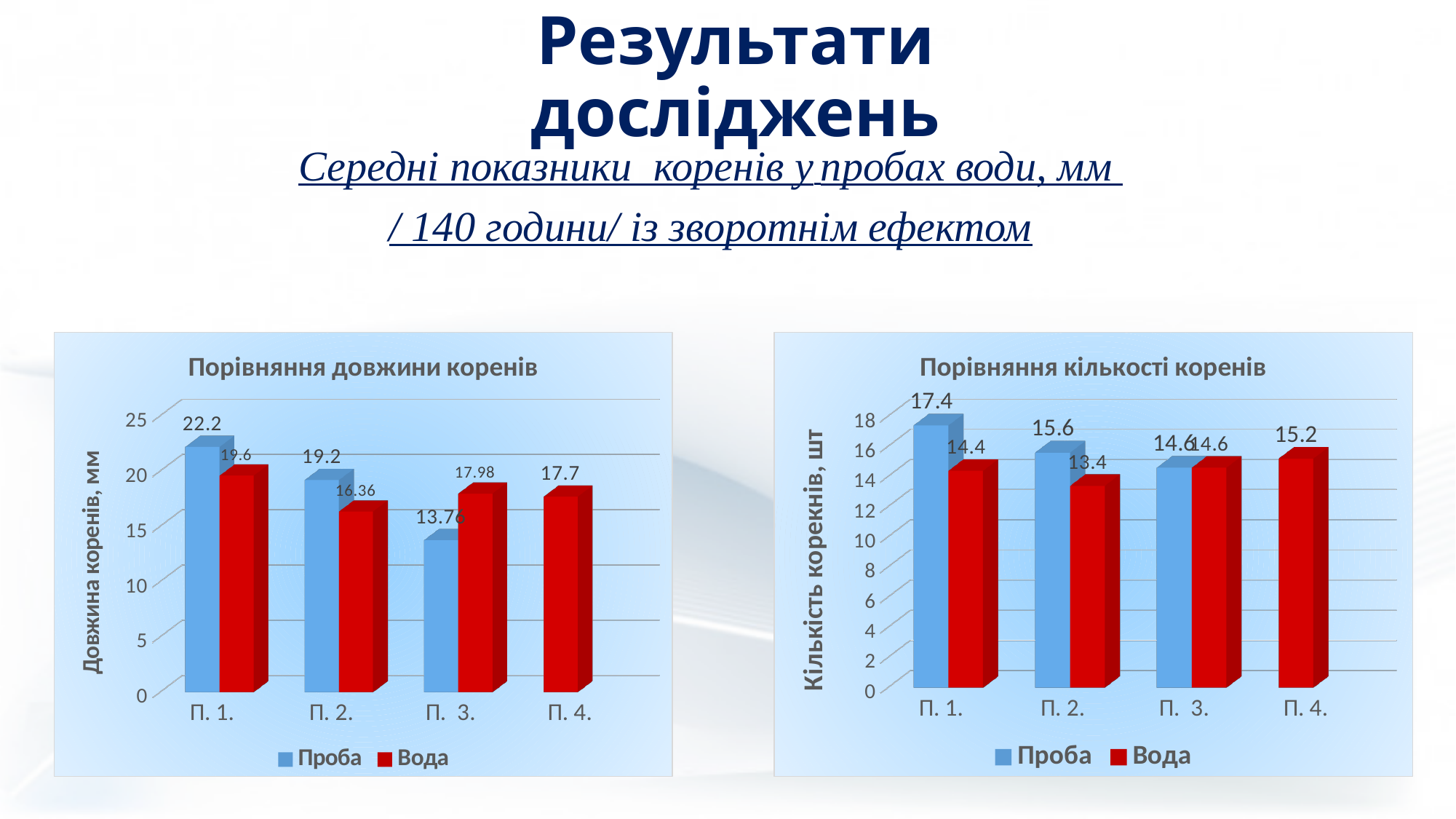
In the chart titled "Порівняння довжини коренів", what is the value of Вода for П. 2.? 16.36 In the chart titled "Порівняння довжини коренів", which is larger for П. 3., Проба or Вода? Вода In the chart titled "Порівняння довжини коренів", what is the value of Проба for П. 1.? 22.2 In the chart titled "Порівняння кількості коренів", what is the difference between Проба and Вода for П. 2.? 2.2 How many series does the legend list in the chart titled "Порівняння кількості коренів"? 2 What type of chart is the chart titled "Порівняння довжини коренів"? Bar chart In the chart titled "Порівняння довжини коренів", which category has the lowest Проба value? П. 3. In the chart titled "Порівняння кількості коренів", what is the value of Проба for П. 1.? 17.4 In the chart titled "Порівняння кількості коренів", which category has the highest Проба value? П. 1. In the chart titled "Порівняння довжини коренів", what is the difference between Проба and Вода for П. 1.? 2.6 In the chart titled "Порівняння кількості коренів", what is the value of Вода for П. 2.? 13.4